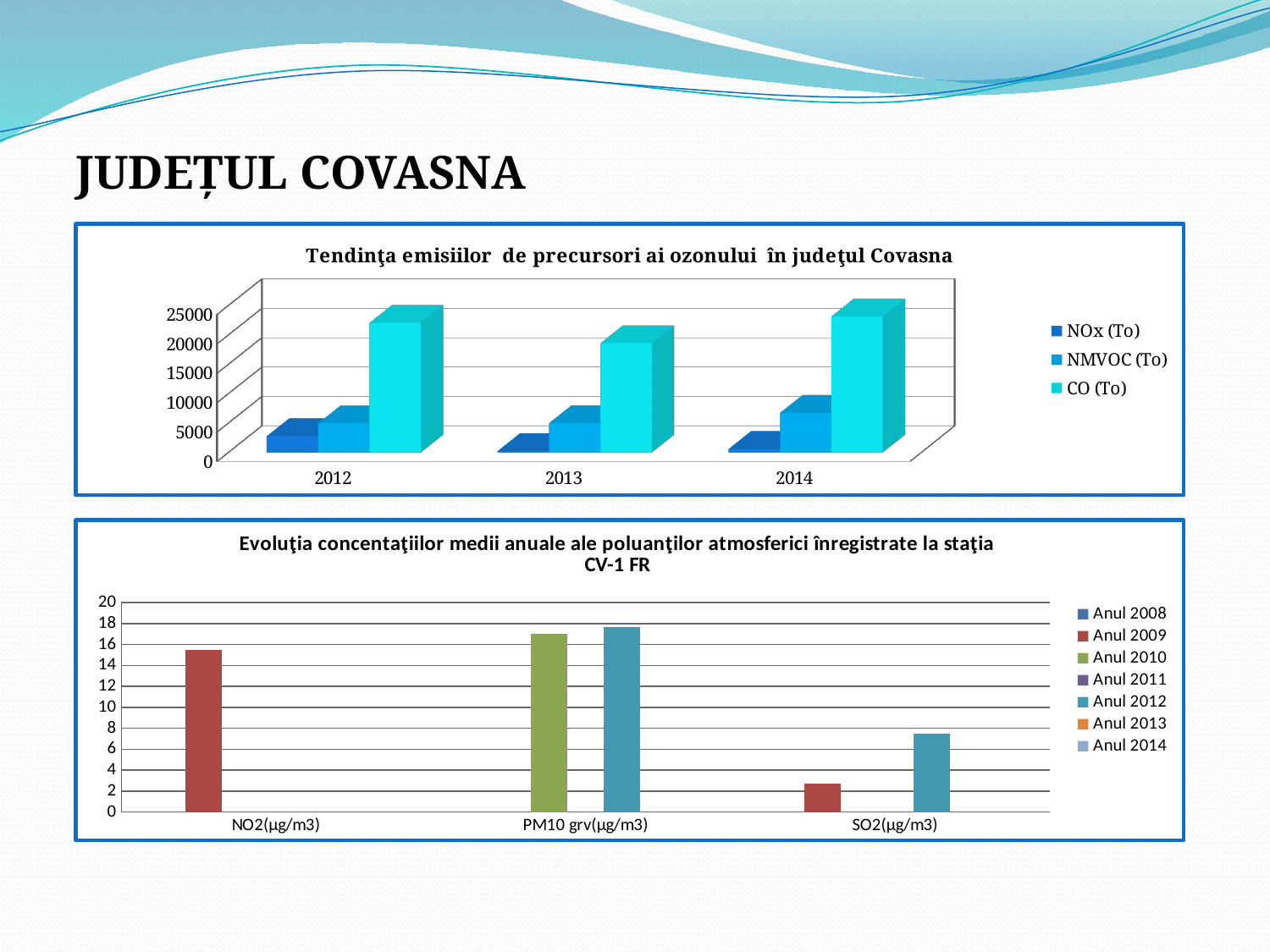
In the top chart, which series has the lowest value in 2012? NOx (To) In the bottom chart, how many pollutant categories are shown on the x axis? 3 In the bottom chart, is the value for NO2(µg/m3) in Anul 2009 greater or less than 14? greater In the bottom chart, is the value for SO2(µg/m3) in Anul 2009 greater or less than 4? less In the bottom chart, which is larger for SO2(µg/m3): the value for Anul 2009 or the value for Anul 2012? Anul 2012 In the top chart, is the value for CO (To) in 2012 greater or less than 15000? greater In the top chart, how many years are shown on the x axis? 3 In the bottom chart, 'Evoluţia concentaţiilor medii anuale ale poluanţilor atmosferici înregistrate la staţia CV-1 FR', how many series does the legend list? 7 In the top chart, which series has the highest value in 2014? CO (To) In the top chart, how many series does the legend list? 3 What kind of chart is the top chart, 'Tendinţa emisiilor de precursori ai ozonului în judeţul Covasna'? bar chart